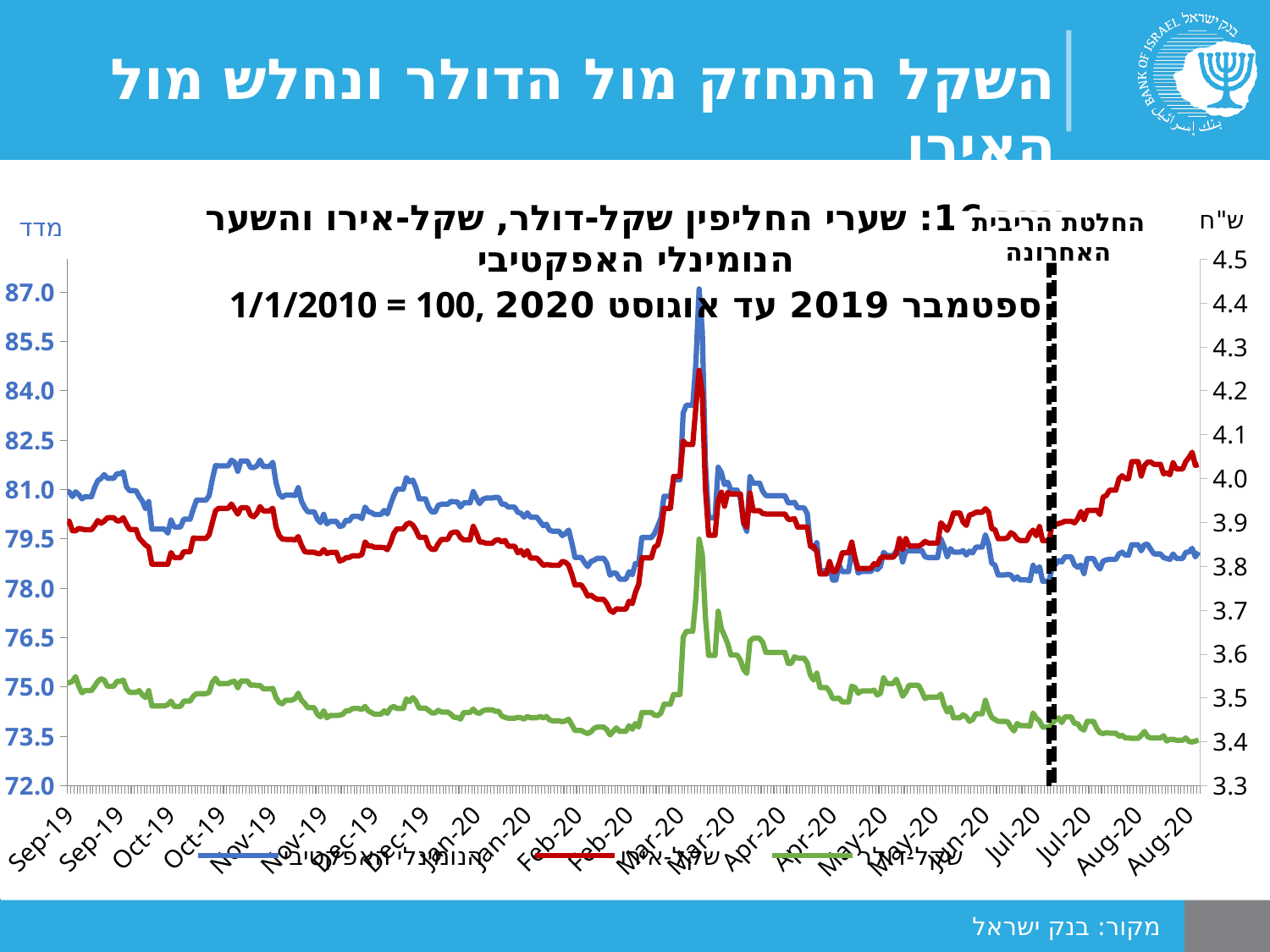
Is the value of the הנומינלי האפקטיבי (blue) line at the end of Aug-20 greater or less than 81.0? less What kind of chart is shown on the slide? line chart How many series does the legend list? 3 What does the dashed vertical line near Jul-20 mark, according to its label? החלטת הריבית האחרונה Is the value of the שקל-דולר (green) line at the end of Aug-20 greater or less than 3.5? less Is the peak of the שקל-דולר (green) line in Mar-20 greater or less than 3.6? greater Does the שקל-אירו (red) line rise or fall from Jun-20 to Aug-20? rise On the right-hand axis, which line is higher at the end of Aug-20: שקל-אירו (red) or שקל-דולר (green)? שקל-אירו (red) Does the שקל-דולר (green) line rise or fall from Apr-20 to Aug-20? fall Which series is drawn in green? שקל-דולר